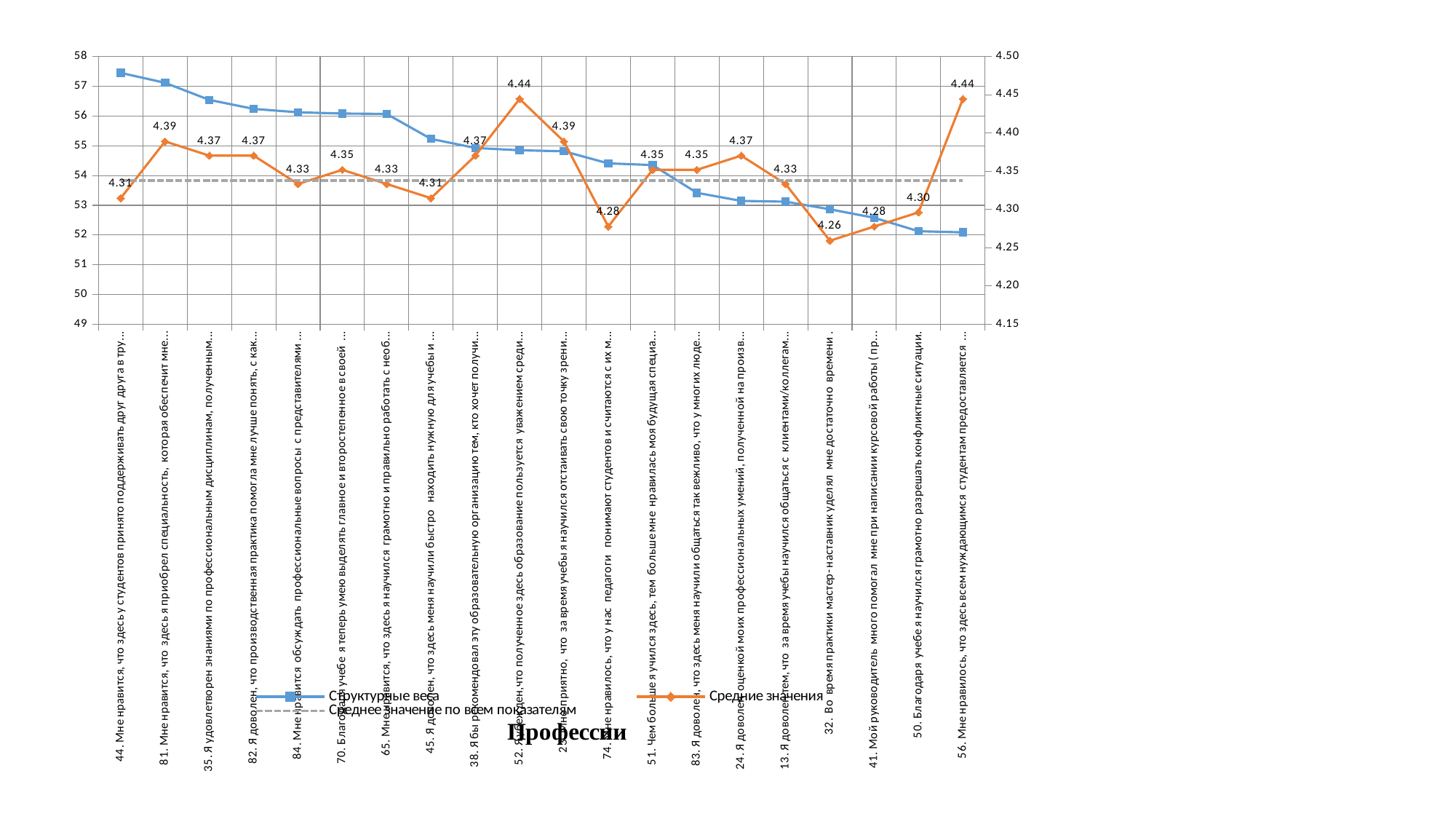
How many series does the legend list? 3 What is the Средние значения value for item 52 ("Я горжусь, что полученное здесь образование пользуется уважением среди…")? 4.44 Which has the larger Средние значения value: item 81 or item 74? 81 Which item has the lowest Средние значения value? 32. Во время практики мастер-наставник уделял мне достаточно времени Is the Структурные веса value for item 44 (the first category) greater or less than 57? greater What is the highest Средние значения value shown on the chart? 4.44 Do the Структурные веса values rise or fall along the x axis? fall What is the difference between the Средние значения values for item 52 and item 32? 0.18 What is the Средние значения value for item 32 ("Во время практики мастер-наставник уделял мне достаточно времени")? 4.26 How many categories are plotted along the x axis? 20 What kind of chart is shown on the slide? line chart What is the Средние значения value for item 50 ("Благодаря учебе я научился грамотно разрешать конфликтные ситуации")? 4.30